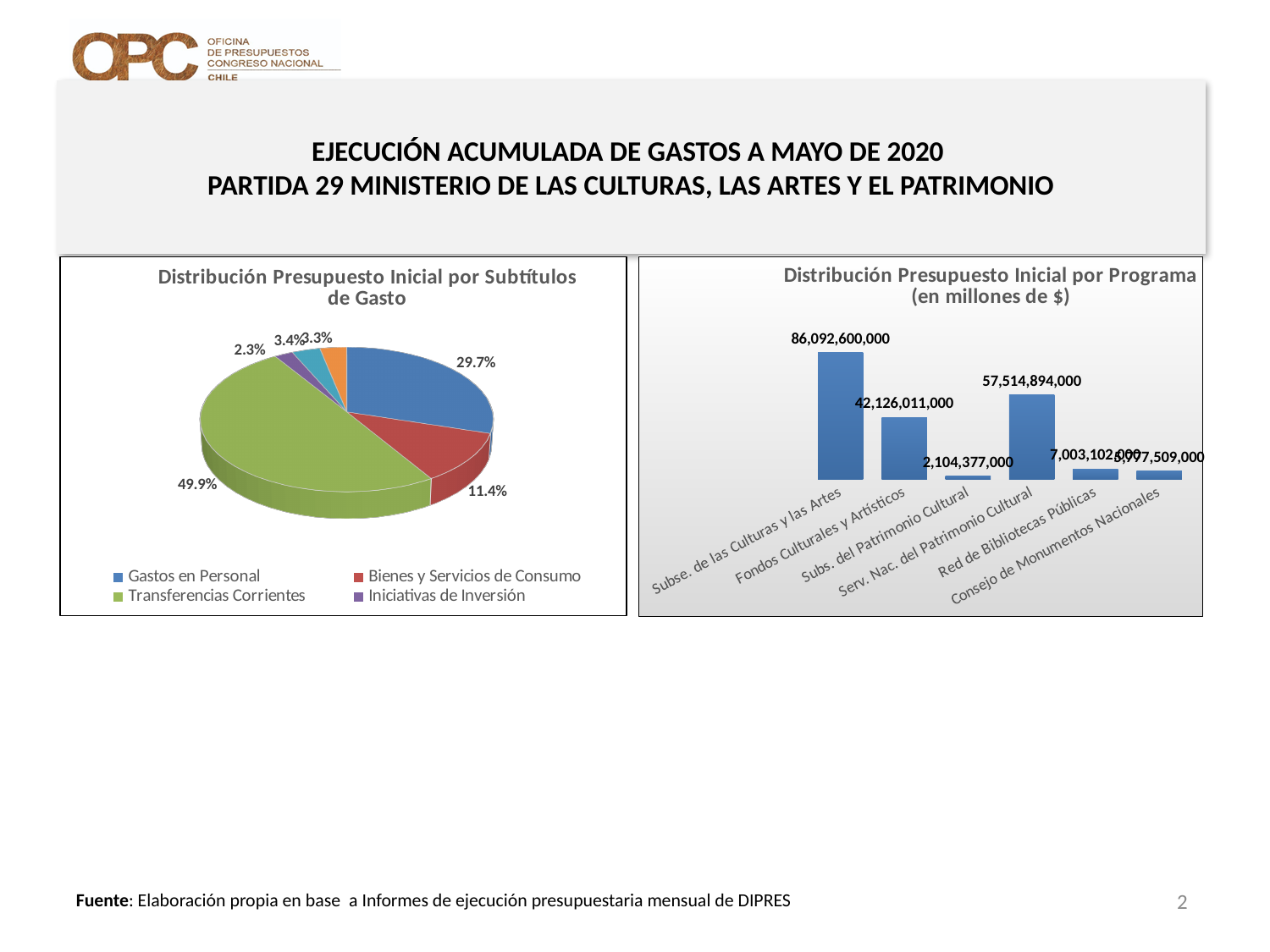
What kind of chart is 'Distribución Presupuesto Inicial por Programa (en millones de $)'? Bar chart In the bar chart 'Distribución Presupuesto Inicial por Programa', what is the difference between Subse. de las Culturas y las Artes and Serv. Nac. del Patrimonio Cultural? 28,577,706,000 In the pie chart 'Distribución Presupuesto Inicial por Subtítulos de Gasto', what share does Gastos en Personal have? 29.7% In the bar chart 'Distribución Presupuesto Inicial por Programa', what is the value for Serv. Nac. del Patrimonio Cultural? 57,514,894,000 In the pie chart 'Distribución Presupuesto Inicial por Subtítulos de Gasto', which category has the largest slice? Transferencias Corrientes In the pie chart 'Distribución Presupuesto Inicial por Subtítulos de Gasto', what share does Transferencias Corrientes have? 49.9% What kind of chart is 'Distribución Presupuesto Inicial por Subtítulos de Gasto'? Pie chart In the bar chart 'Distribución Presupuesto Inicial por Programa', what is the value for Fondos Culturales y Artísticos? 42,126,011,000 In the pie chart 'Distribución Presupuesto Inicial por Subtítulos de Gasto', what share does Bienes y Servicios de Consumo have? 11.4% In the bar chart 'Distribución Presupuesto Inicial por Programa', which program has the lowest value? Subs. del Patrimonio Cultural How many entries does the legend of the pie chart 'Distribución Presupuesto Inicial por Subtítulos de Gasto' list? 4 In the bar chart 'Distribución Presupuesto Inicial por Programa', which program has the highest value? Subse. de las Culturas y las Artes